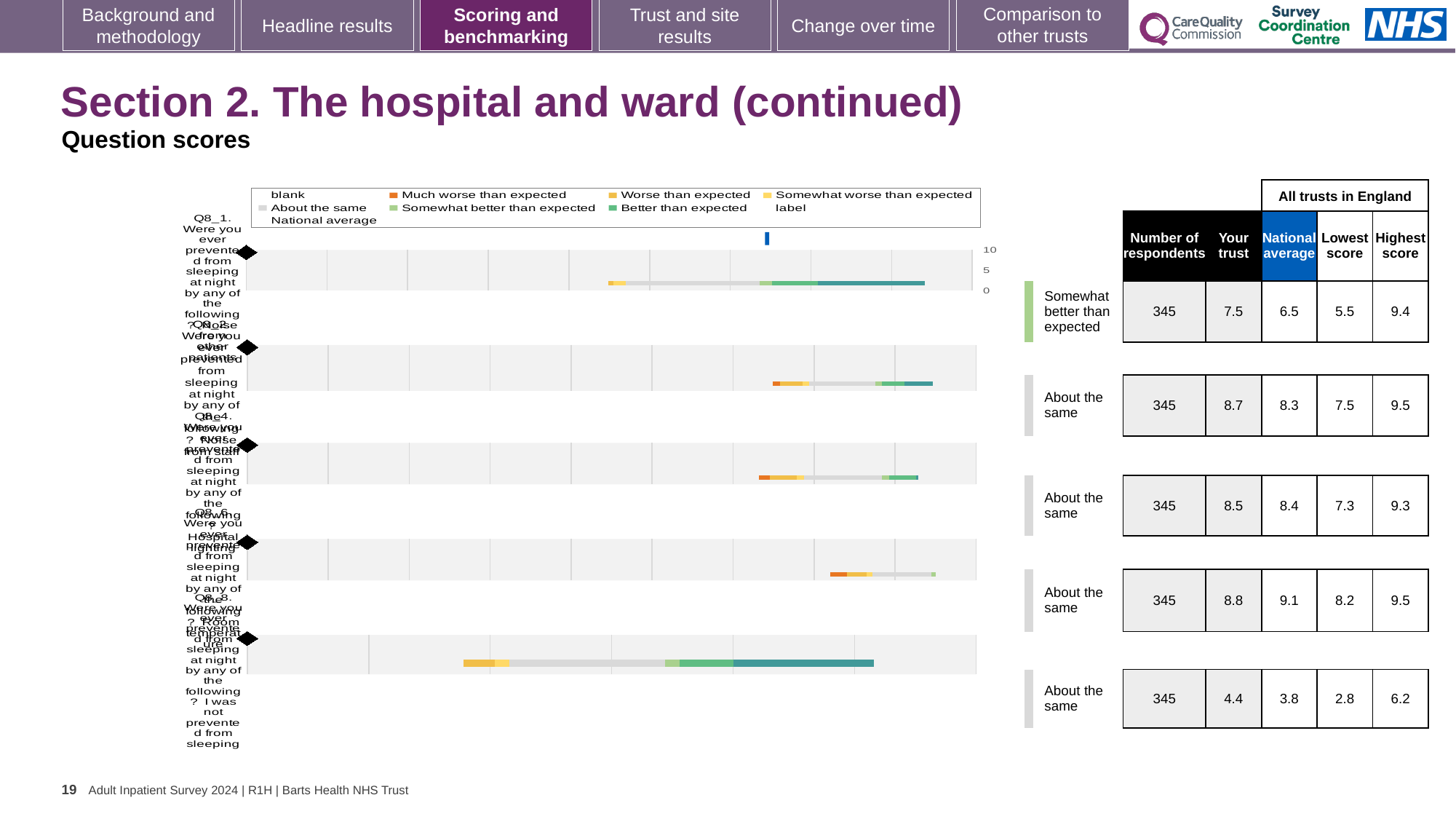
What is the highest tick value shown on the chart's axis? 10 Which question label is plotted in the last (bottom) bar of the chart? Q8_8 How many question bars are plotted in the chart? 5 How many entries does the chart legend list? 9 Which legend entry is shown in grey in the chart? About the same What kind of chart is shown on the slide? bar chart Which question label is plotted in the first (top) bar of the chart? Q8_1